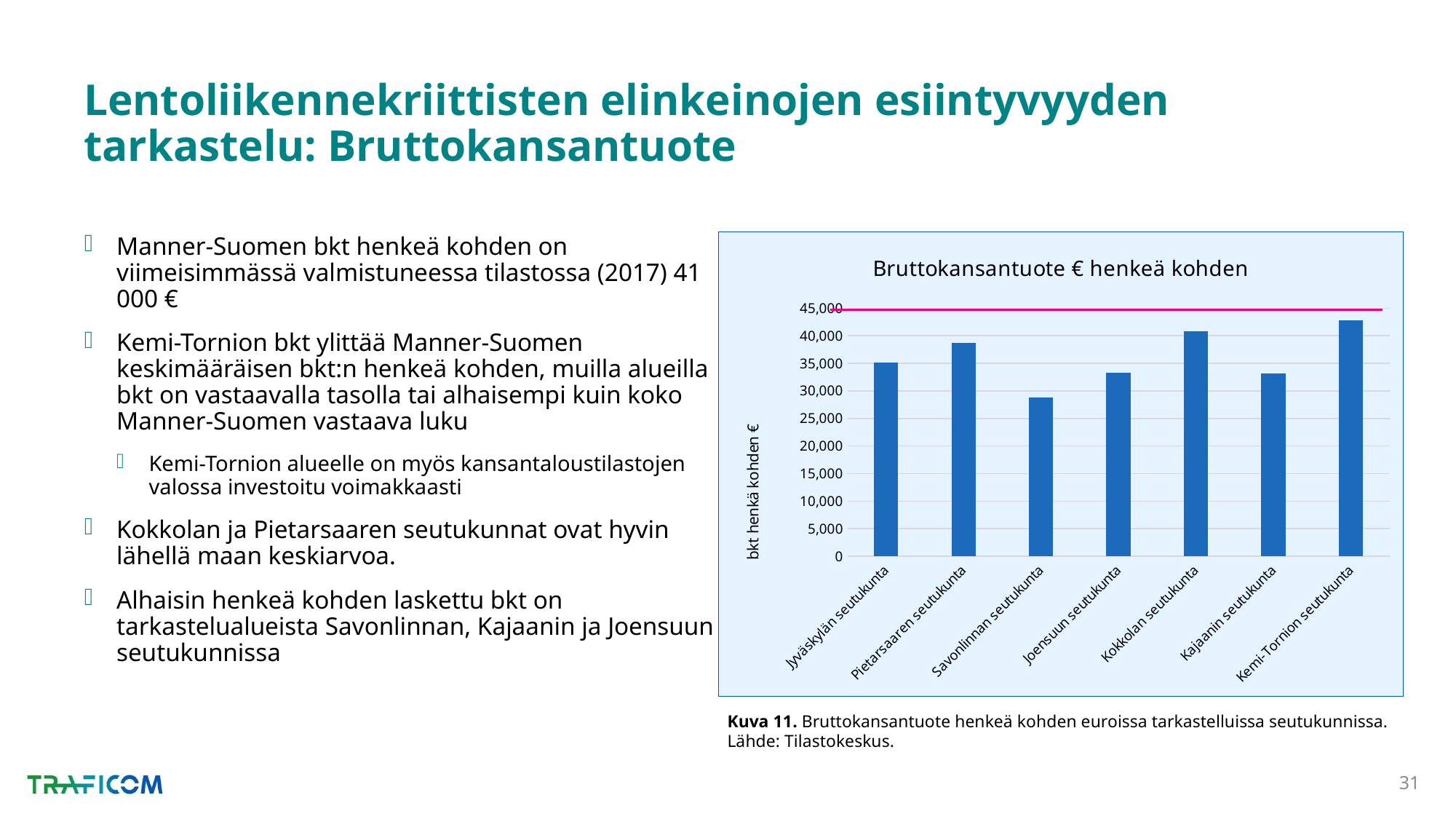
Is the value for Kokkolan seutukunta greater or less than 35,000? greater Which is larger, the value for Kokkolan seutukunta or Joensuun seutukunta? Kokkolan seutukunta What kind of chart is shown on the slide? Bar chart How many seutukunta categories are plotted in the chart? 7 Which seutukunta has the lowest GDP per capita in the chart? Savonlinnan seutukunta Is the value for Kemi-Tornion seutukunta greater or less than 40,000? greater Is the value for Savonlinnan seutukunta greater or less than 35,000? less What is the title of the chart? Bruttokansantuote € henkeä kohden Which is larger, the value for Pietarsaaren seutukunta or Jyväskylän seutukunta? Pietarsaaren seutukunta Which seutukunta has the highest GDP per capita in the chart? Kemi-Tornion seutukunta